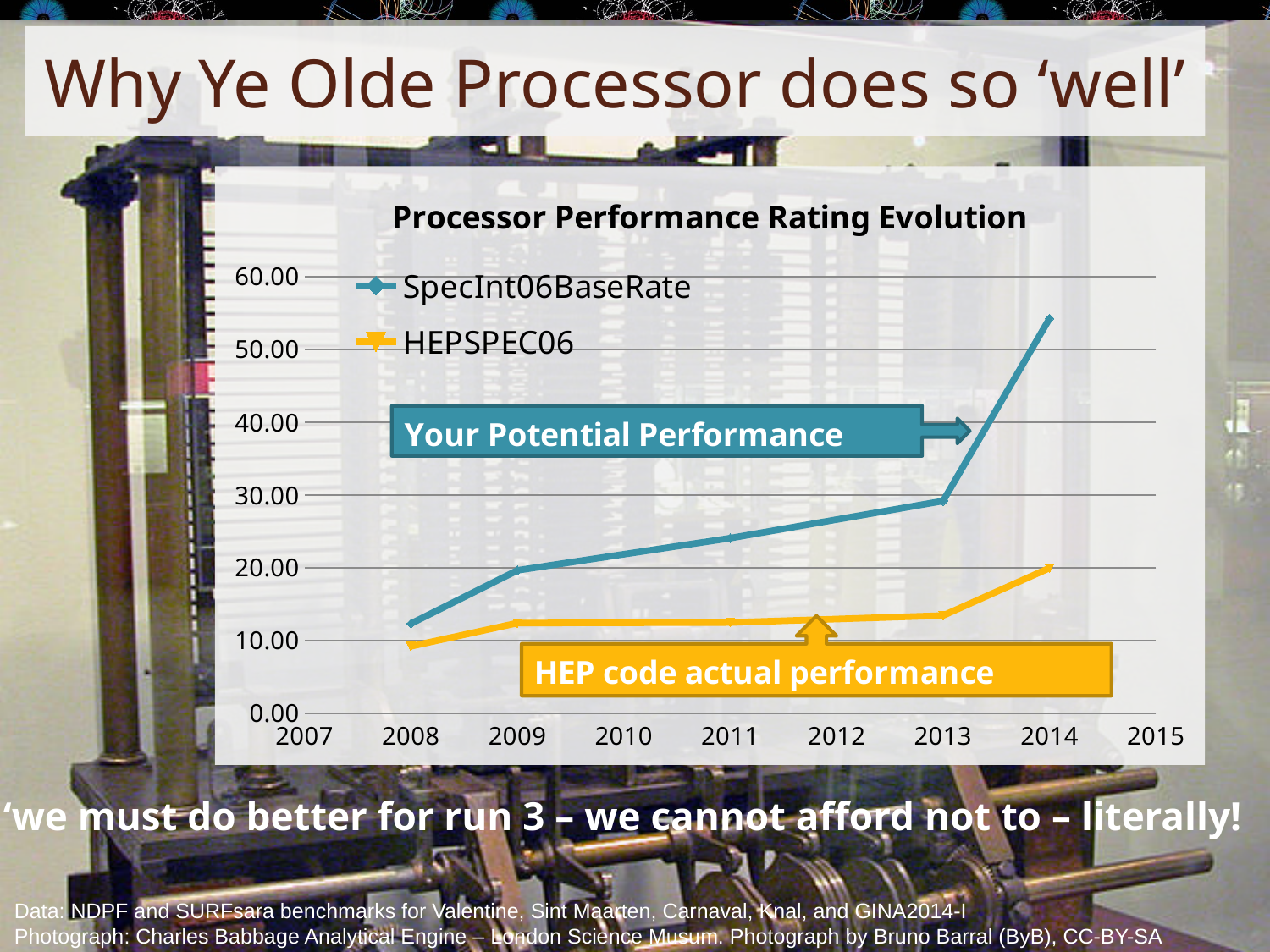
In which year is HEPSPEC06 at its lowest value? 2008 In 2014, which series has the larger value, SpecInt06BaseRate or HEPSPEC06? SpecInt06BaseRate What kind of chart is shown on the slide? line chart How many series does the chart's legend list? 2 Is the SpecInt06BaseRate value for 2014 greater or less than 50.00? greater How many data points are plotted for the HEPSPEC06 series? 5 What is the title of the chart? Processor Performance Rating Evolution Does the SpecInt06BaseRate series rise or fall from 2008 to 2014? rise Is the SpecInt06BaseRate value for 2013 greater or less than 20.00? greater Is the HEPSPEC06 value for 2013 greater or less than 20.00? less Which series is drawn in yellow? HEPSPEC06 In which year does SpecInt06BaseRate reach its highest value? 2014